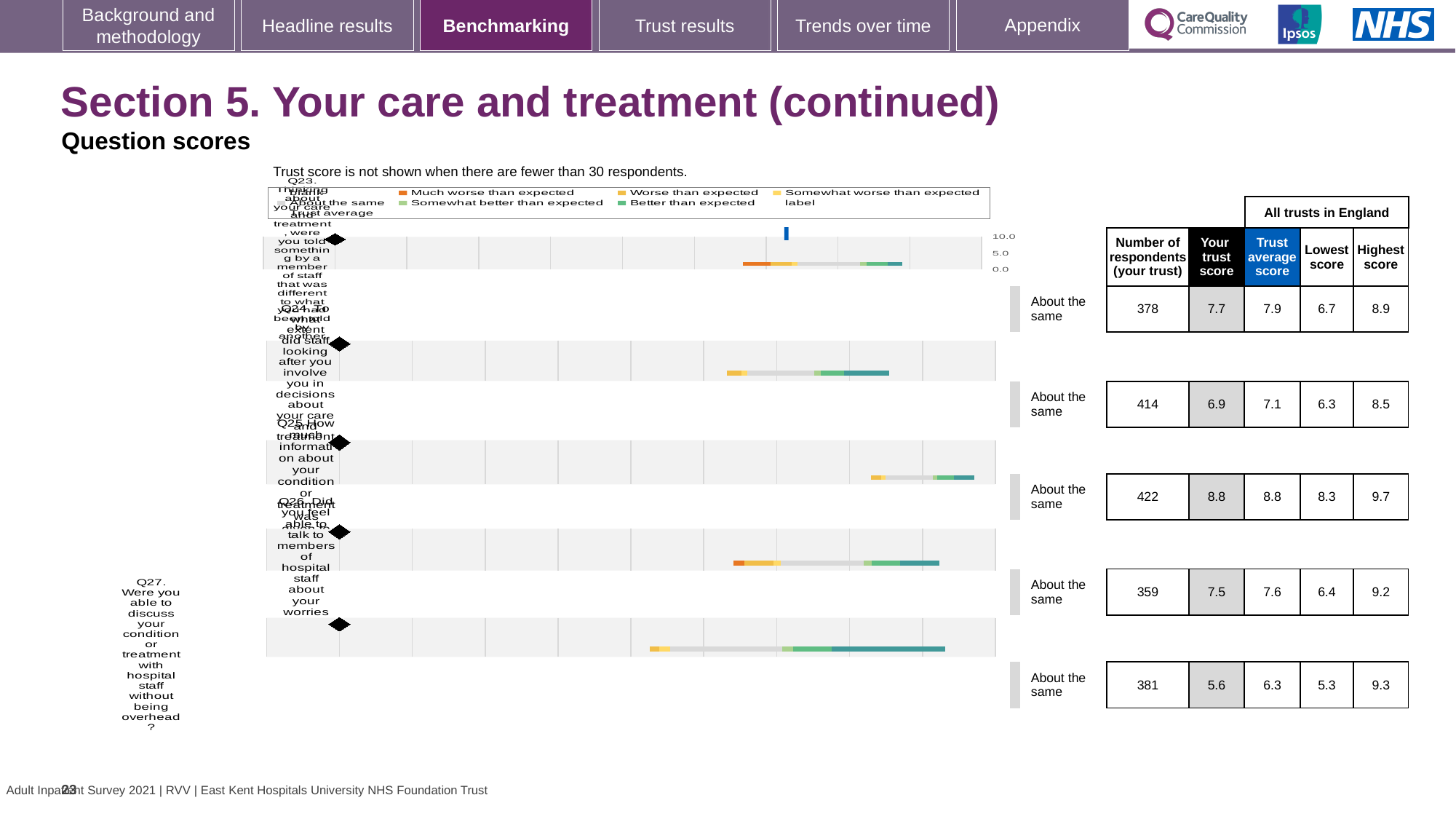
For Q23, which is larger: the trust score or the trust average score? Trust average score How many questions (rows) are plotted in the chart? 5 Which question has the lowest trust score on this slide? Q27 Which question has the highest trust score on this slide? Q25 What kind of chart is used to show the question scores? Bar chart What is the trust score for Q27 (able to discuss your condition or treatment without being overheard)? 5.6 What is the trust score for Q25 (how much information about your condition or treatment was given)? 8.8 What benchmark category is shown for Q24? About the same What is the trust average score for Q24 (did staff involve you in decisions about your care and treatment)? 7.1 What is the difference between the trust average score and the trust score for Q27? 0.7 What is the highest score across all trusts in England for Q26? 9.2 How many respondents from the trust answered Q23? 378